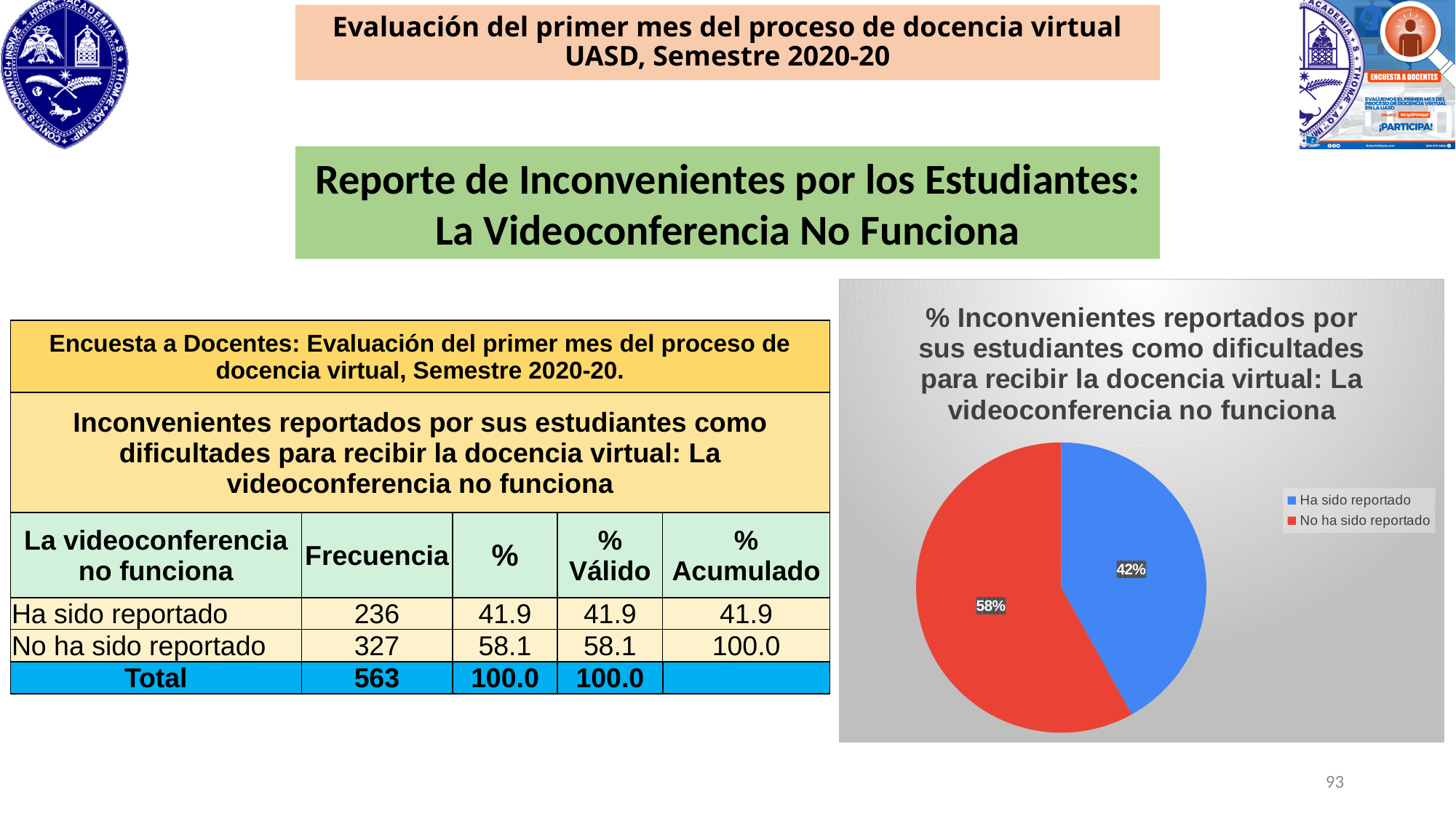
What percentage does the pie chart show for "Ha sido reportado"? 42% What percentage does the pie chart show for "No ha sido reportado"? 58% How many slices does the pie chart have? 2 What is the difference in percentage points between the "No ha sido reportado" and "Ha sido reportado" slices in the pie chart? 16% What colour is the "Ha sido reportado" slice in the pie chart? blue In the pie chart, which is larger: "Ha sido reportado" or "No ha sido reportado"? No ha sido reportado Is the share of the "Ha sido reportado" slice in the pie chart greater or less than 50%? less How many entries does the pie chart legend list? 2 Which slice of the pie chart is the smallest? Ha sido reportado Which slice of the pie chart is the largest? No ha sido reportado What colour is the "No ha sido reportado" slice in the pie chart? red What kind of chart is shown on the slide? pie chart